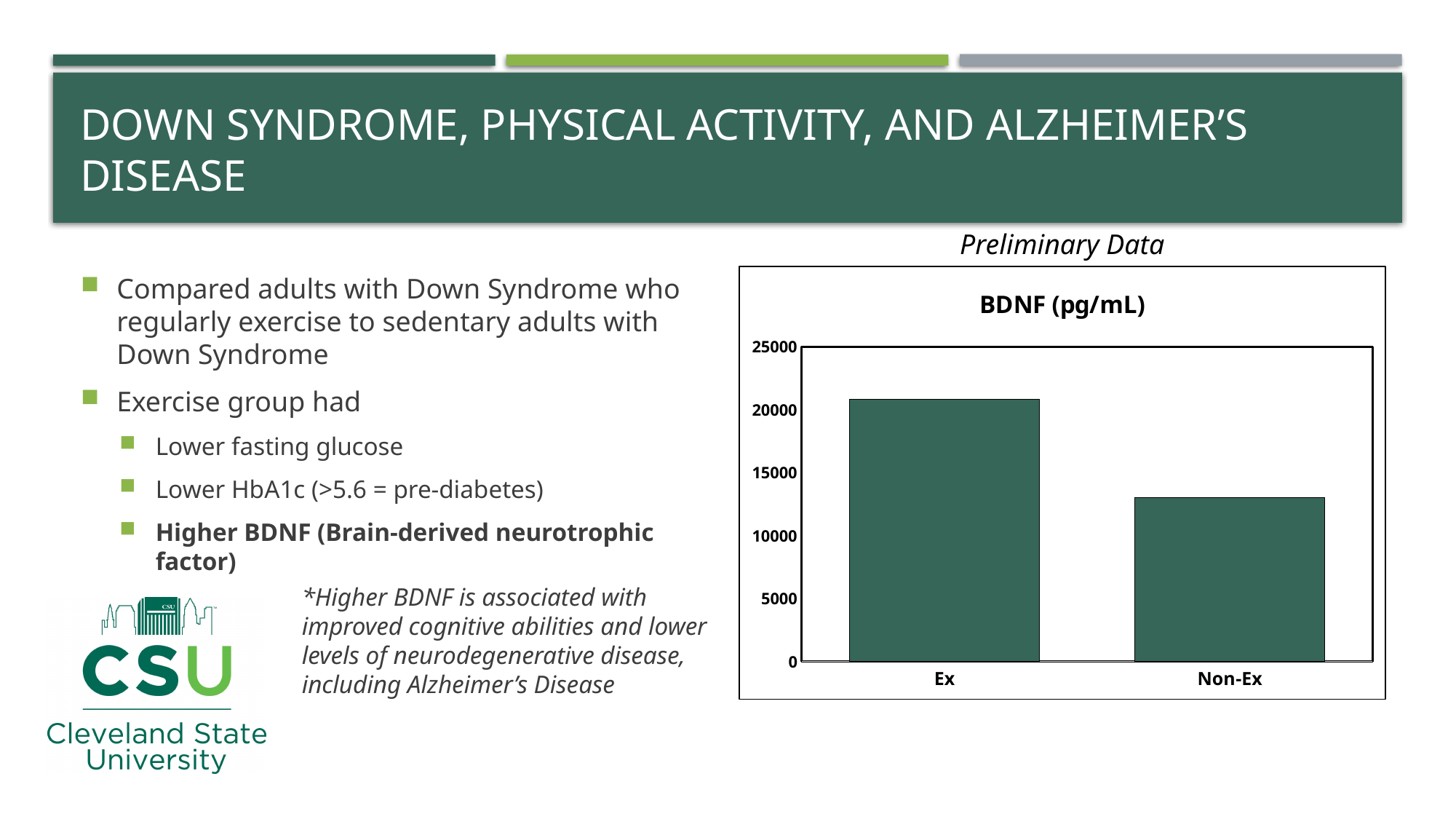
Which bar is taller, Ex or Non-Ex? Ex Is the value for Non-Ex greater or less than 15000? less Do the values rise or fall going from Ex to Non-Ex along the x axis? Fall Is the value for Non-Ex greater or less than 10000? greater Which group has the lowest BDNF value? Non-Ex What kind of chart is shown on the slide? Bar chart What is the highest value shown on the chart's y axis? 25000 How many bars are plotted in the chart? 2 Which group has the highest BDNF value? Ex Is the value for Ex greater or less than 25000? less What is the title of the chart? BDNF (pg/mL)